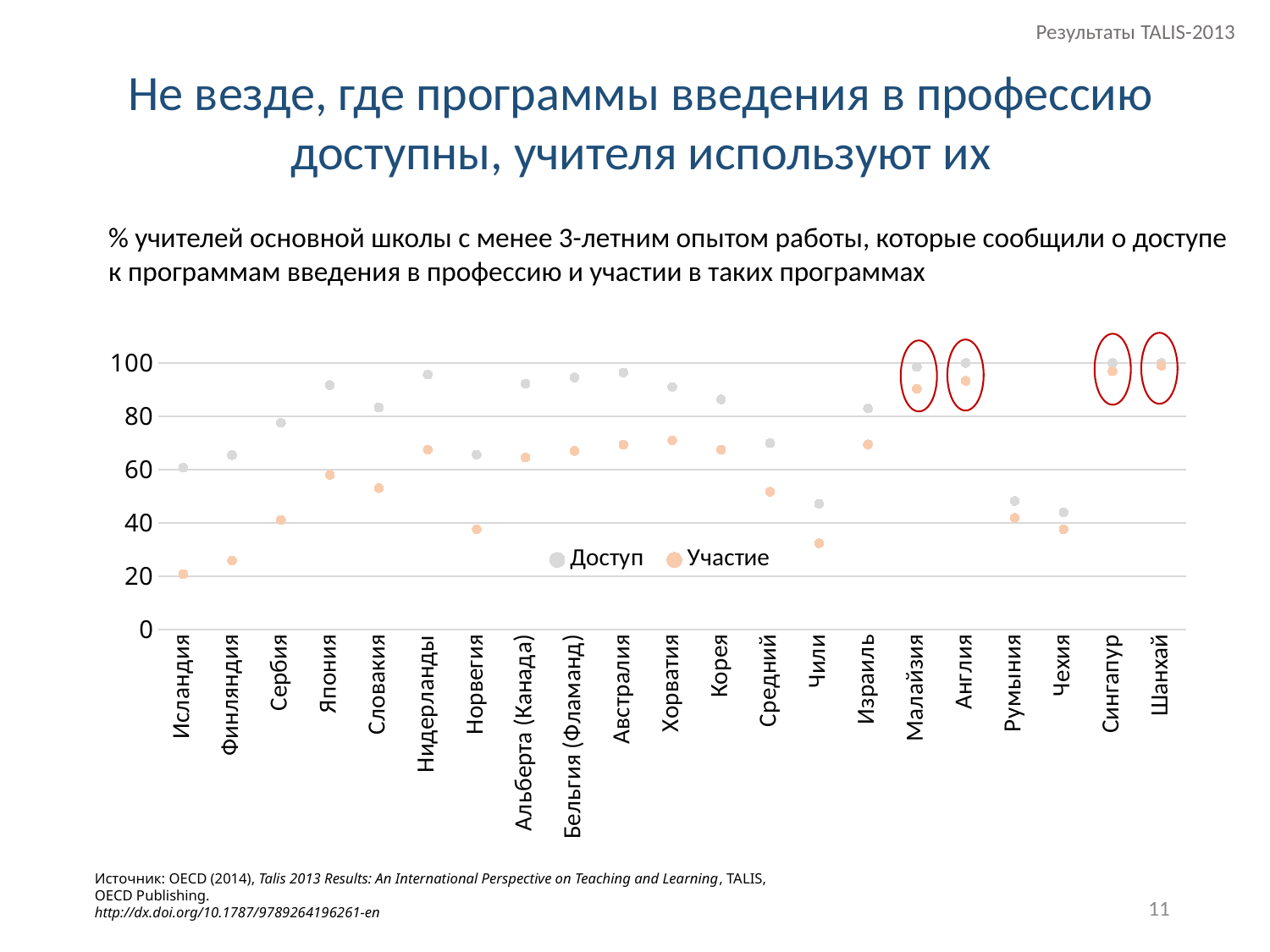
What kind of chart is this? Scatter (dot) chart Is the Доступ value for Япония greater or less than 80? greater Is the Участие value for Словакия greater or less than 60? less How many series does the legend list? 2 For Исландия, which is larger: Доступ or Участие? Доступ Is the Доступ value for Румыния greater or less than 60? less Which has the larger Доступ value: Нидерланды or Норвегия? Нидерланды Which category has the lowest value for Участие? Исландия What are the two series named in the legend? Доступ and Участие How many countries/categories are shown on the x axis? 21